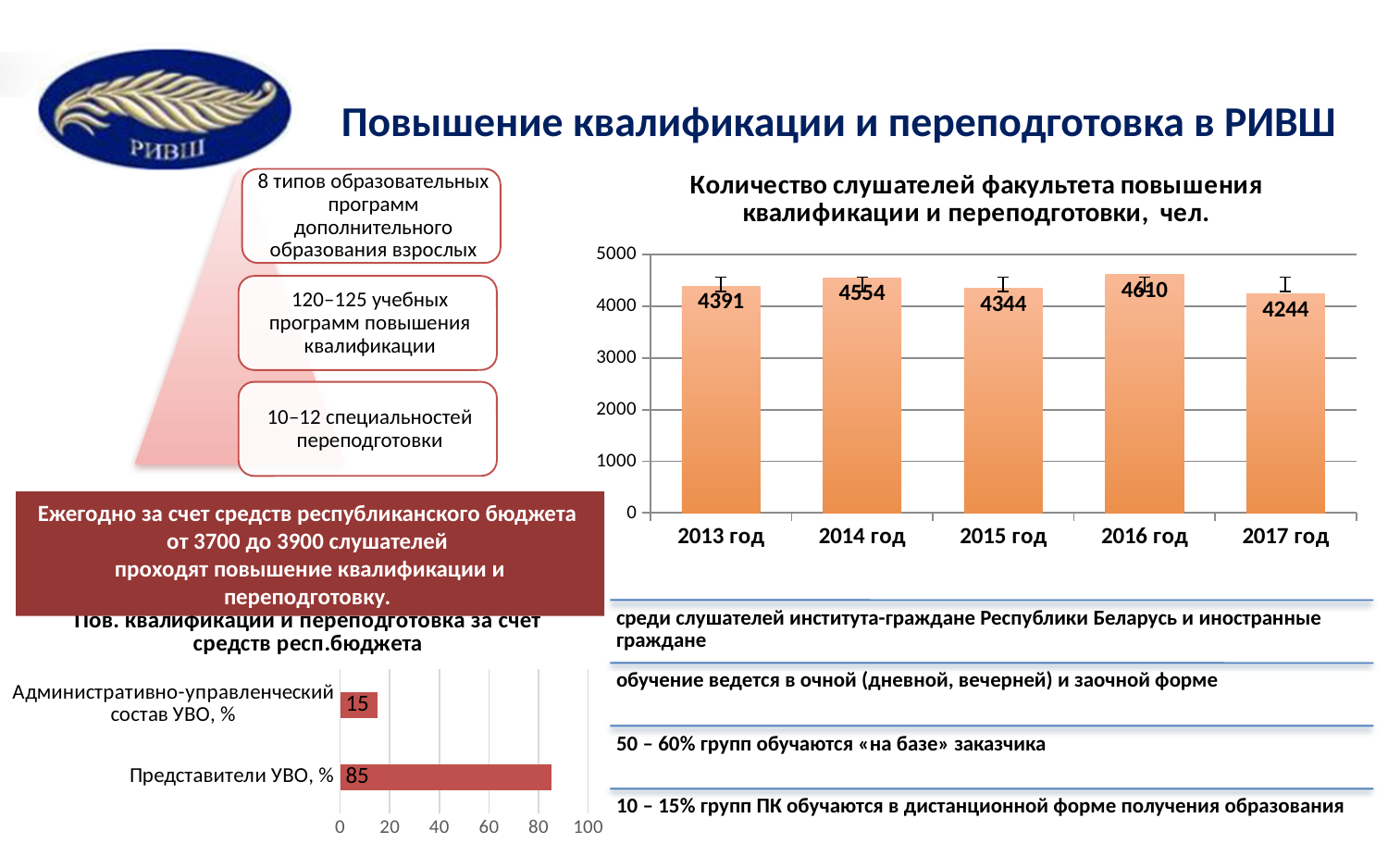
In the chart 'Количество слушателей факультета повышения квалификации и переподготовки, чел.', what is the value for 2017 год? 4244 In the chart 'Количество слушателей факультета повышения квалификации и переподготовки, чел.', how many years are shown on the x axis? 5 In the chart 'Количество слушателей факультета повышения квалификации и переподготовки, чел.', what is the difference between the values for 2016 год and 2017 год? 366 In the chart 'Количество слушателей факультета повышения квалификации и переподготовки, чел.', which year has the highest value? 2016 год In the chart 'Количество слушателей факультета повышения квалификации и переподготовки, чел.', which is larger: the value for 2013 год or 2015 год? 2013 год In the chart 'Пов. квалификации и переподготовка за счет средств респ.бюджета', what is the value for 'Административно-управленческий состав УВО, %'? 15 In the chart 'Пов. квалификации и переподготовка за счет средств респ.бюджета', what is the value for 'Представители УВО, %'? 85 In the chart 'Пов. квалификации и переподготовка за счет средств респ.бюджета', what is the difference between the two bars? 70 In the chart 'Количество слушателей факультета повышения квалификации и переподготовки, чел.', what is the value for 2014 год? 4554 In the chart 'Пов. квалификации и переподготовка за счет средств респ.бюджета', how many categories are shown? 2 In the chart 'Количество слушателей факультета повышения квалификации и переподготовки, чел.', which year has the lowest value? 2017 год What kind of chart is 'Количество слушателей факультета повышения квалификации и переподготовки, чел.'? Bar chart